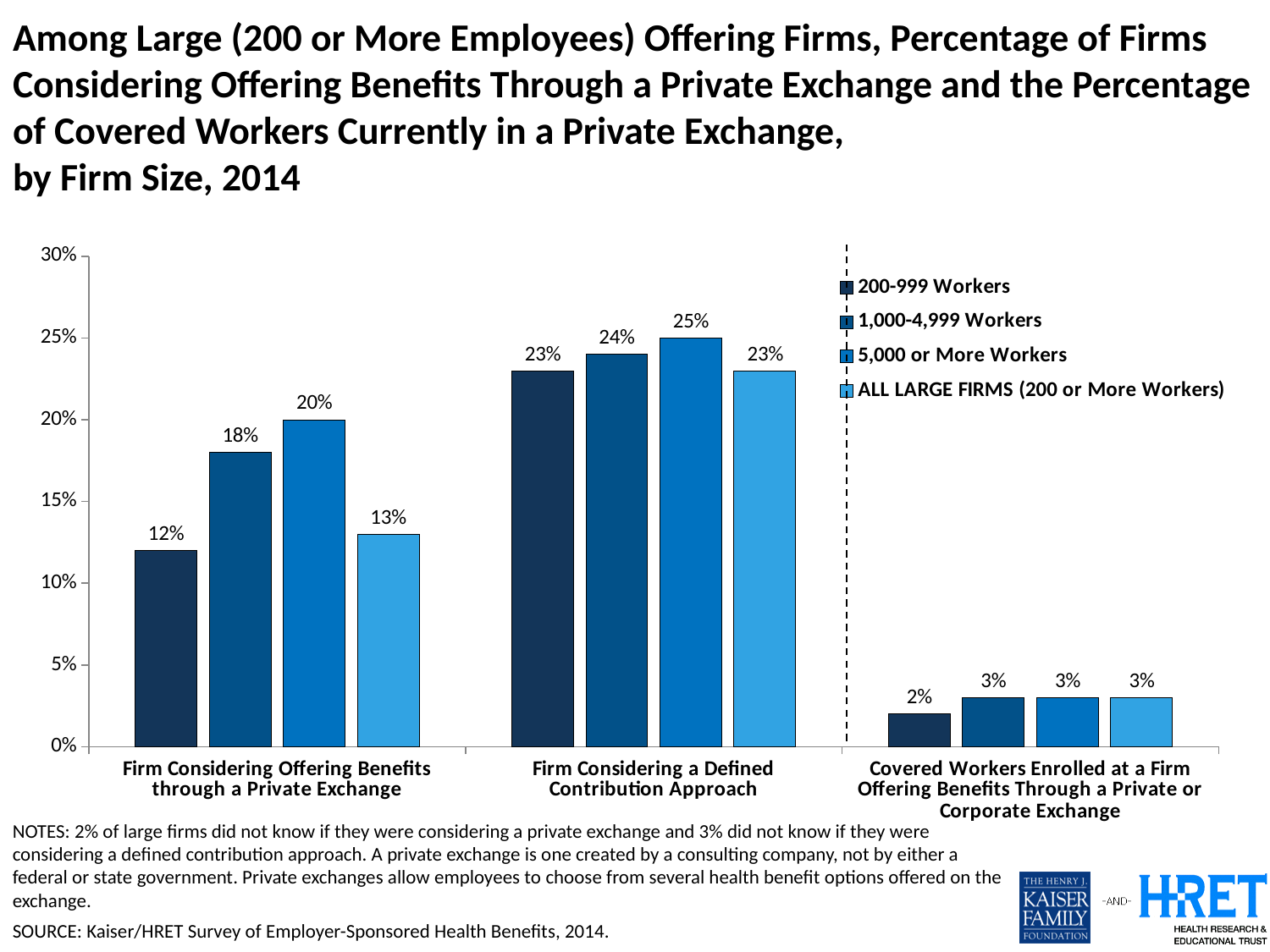
What kind of chart is shown on the slide? Bar chart How many categories are shown on the x axis? 3 Which firm size has the lowest percentage considering a defined contribution approach? 200-999 Workers What percentage of firms with 200-999 workers are considering offering benefits through a private exchange? 12% Which firm size has the highest percentage considering offering benefits through a private exchange? 5,000 or More Workers What is the difference between the 5,000 or More Workers value and the 200-999 Workers value for firms considering offering benefits through a private exchange? 8 percentage points What is the source cited for the chart? Kaiser/HRET Survey of Employer-Sponsored Health Benefits, 2014 How many series does the legend list? 4 What is the value for 5,000 or More Workers in the 'Firm Considering a Defined Contribution Approach' category? 25% What is the value for ALL LARGE FIRMS (200 or More Workers) in the 'Firm Considering Offering Benefits through a Private Exchange' category? 13% Which is larger: the 1,000-4,999 Workers value for considering a private exchange or the 1,000-4,999 Workers value for considering a defined contribution approach? Considering a defined contribution approach What percentage of covered workers at firms with 200-999 workers are enrolled at a firm offering benefits through a private or corporate exchange? 2%